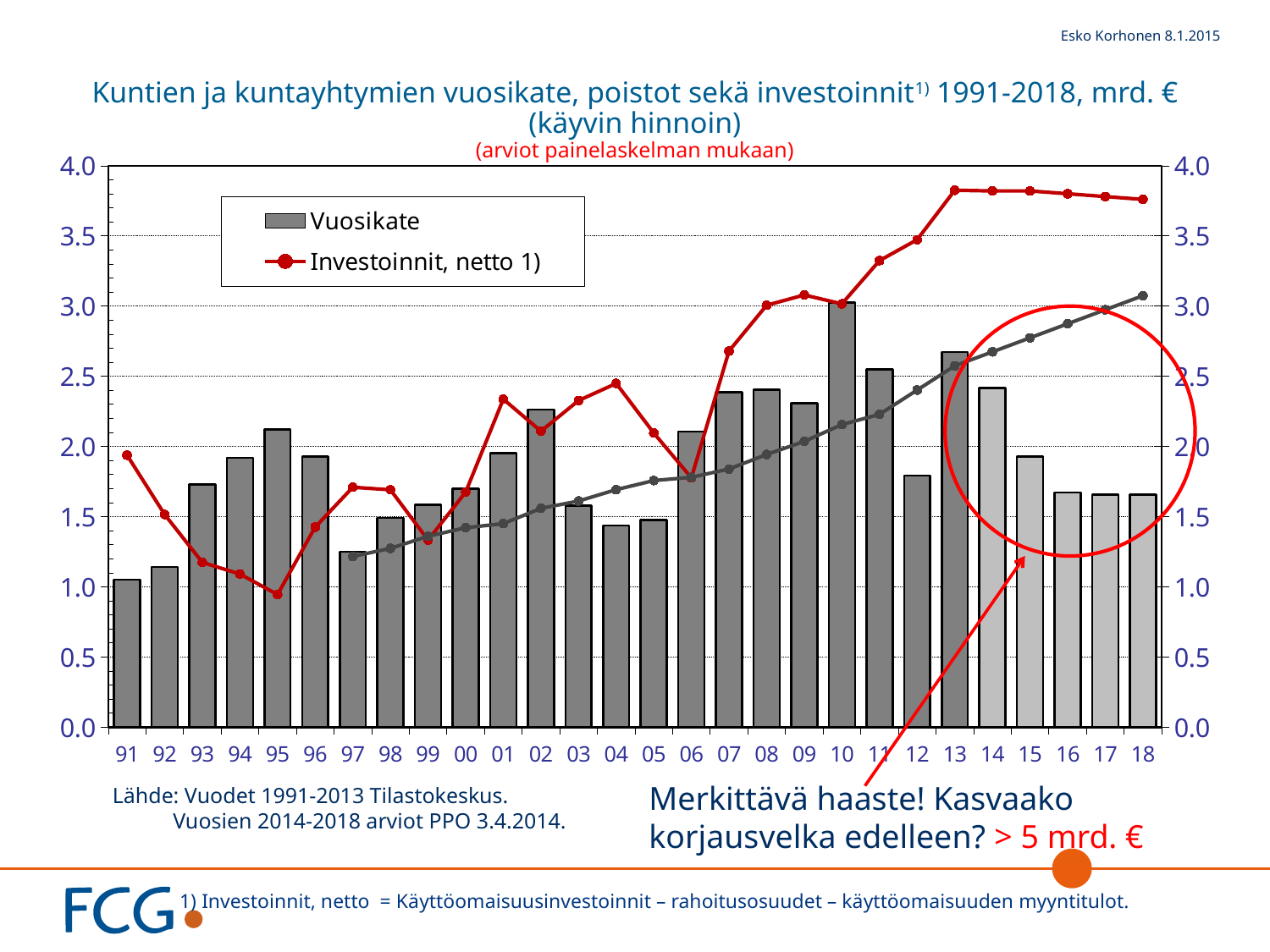
Is the Vuosikate value for 95 greater or less than 2.0? greater In which year is the Vuosikate bar the lowest? 91 Is the Vuosikate value for 18 greater or less than 2.0? less What colour is the Investoinnit, netto line in the chart? Red Does the Vuosikate series rise or fall from 14 to 18? It falls Is the Investoinnit, netto value for 13 greater or less than 3.5? greater In which year is the Vuosikate bar the highest? 10 How many years are shown on the x axis of the chart? 28 How many series does the chart legend list? 2 What kind of chart is shown on the slide? A combined bar and line chart In which year is the Investoinnit, netto line at its lowest point? 95 Which year has the larger Vuosikate bar, 10 or 12? 10